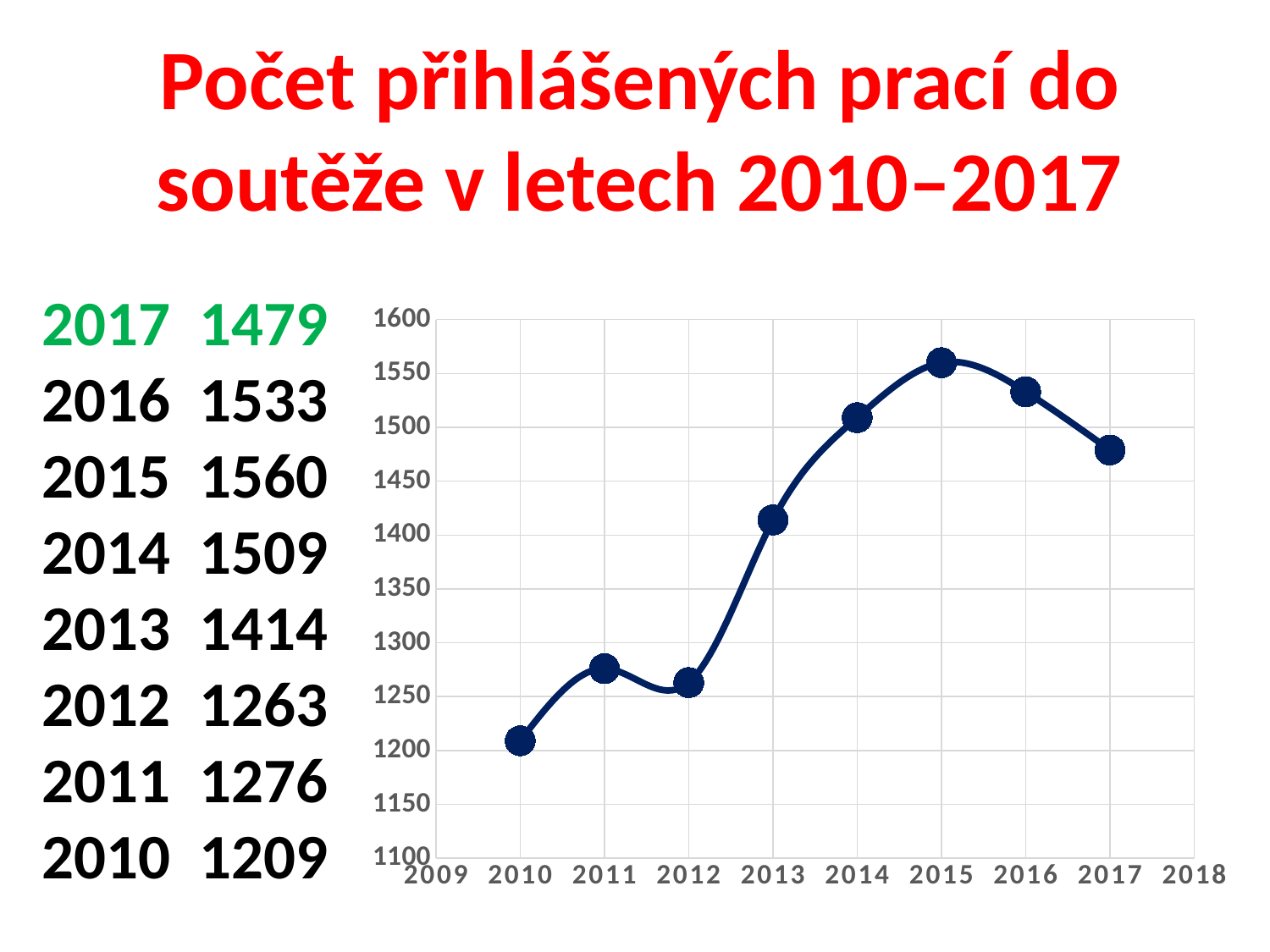
How many data points are plotted on the chart? 8 What is the difference between the values for 2015 and 2010? 351 Which year has the highest value? 2015 Which year has the lowest value? 2010 What kind of chart is shown on the slide? line chart What is the value for 2015? 1560 What is the value for 2013? 1414 Do the values rise or fall from 2010 to 2015? rise Which is larger, the value for 2014 or the value for 2013? 2014 What is the difference between the values for 2016 and 2017? 54 What is the value for 2010? 1209 Is the value for 2013 greater or less than 1400? greater